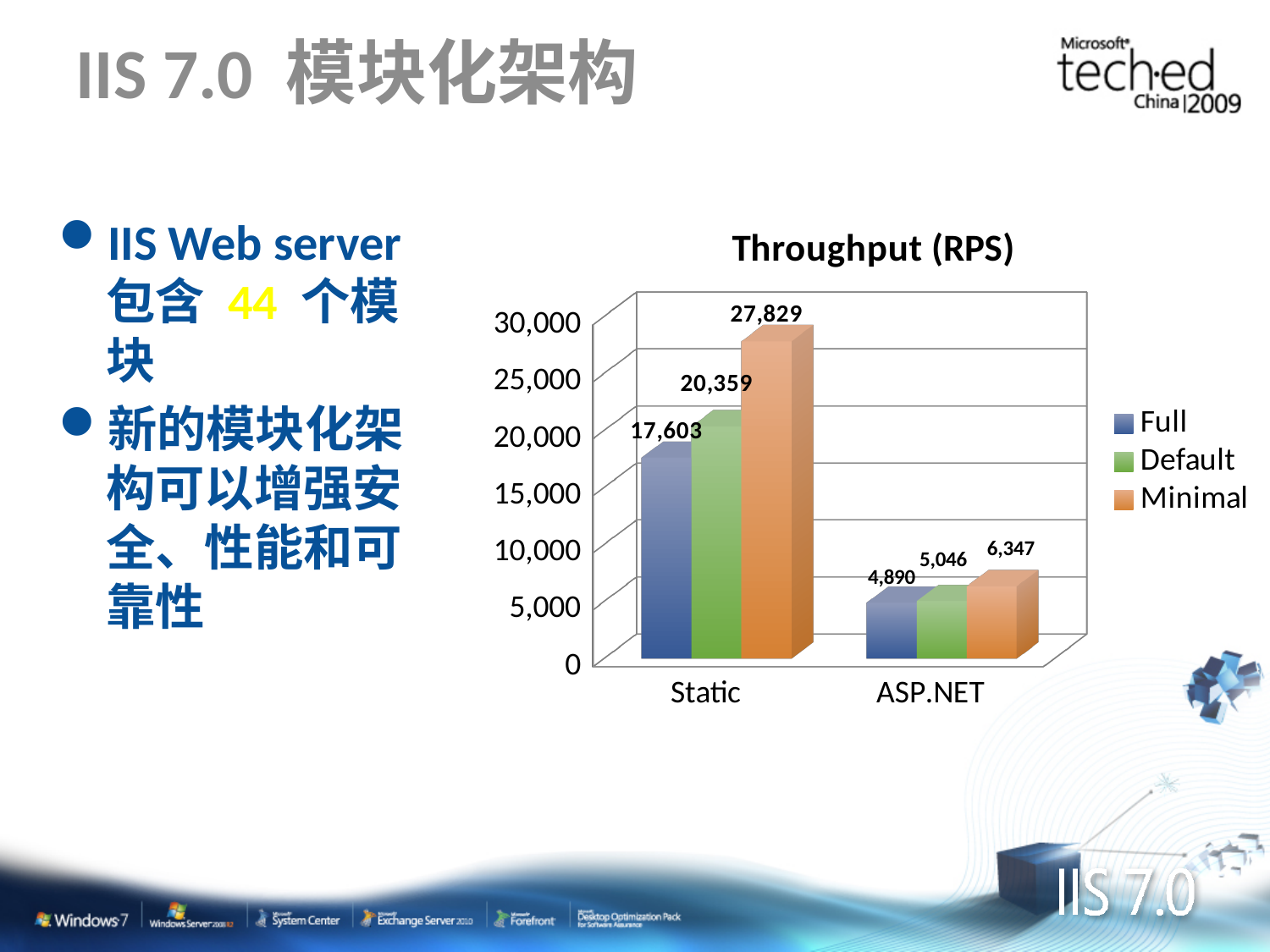
Which is larger: the Default value for Static or the Minimal value for ASP.NET? Default value for Static What is the Throughput (RPS) value for Full in the ASP.NET category? 4,890 What is the Throughput (RPS) value for Default in the Static category? 20,359 What is the difference between the Minimal and Default throughput values in the ASP.NET category? 1,301 What type of chart is shown on the slide? Bar chart What is the difference between the Minimal and Full throughput values in the Static category? 10,226 Is the Full value for Static greater or less than 15,000? greater What is the Throughput (RPS) value for Minimal in the Static category? 27,829 How many series does the chart legend list? 3 Which series has the highest throughput in the ASP.NET category? Minimal Which series has the lowest throughput in the Static category? Full How many categories are shown on the x axis of the chart? 2